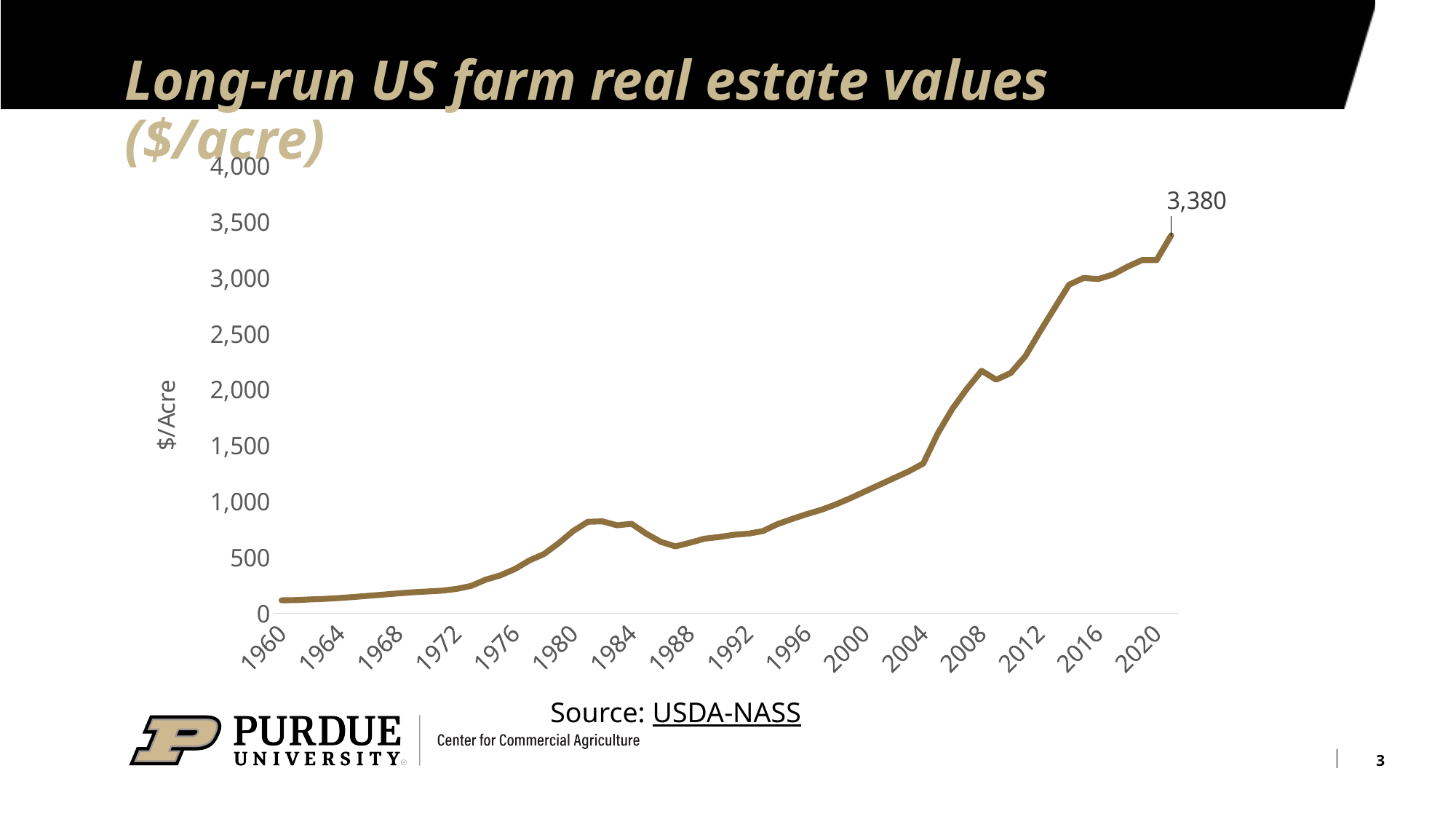
Which year has the larger value, 1980 or 1988? 1980 What value is printed as the data label at the end of the line? 3,380 What is the highest value reached by the line? 3,380 Which year on the x axis has the lowest farm real estate value? 1960 Is the value for 2020 greater or less than 3,000? greater What kind of chart is shown on the slide? line chart Is the value for 2004 greater or less than 1,000? greater What is the label on the vertical axis? $/Acre Do farm real estate values generally rise or fall from 1960 to 2020? rise Is the value for 1980 greater or less than 1,000? less How many year labels are shown on the x axis? 16